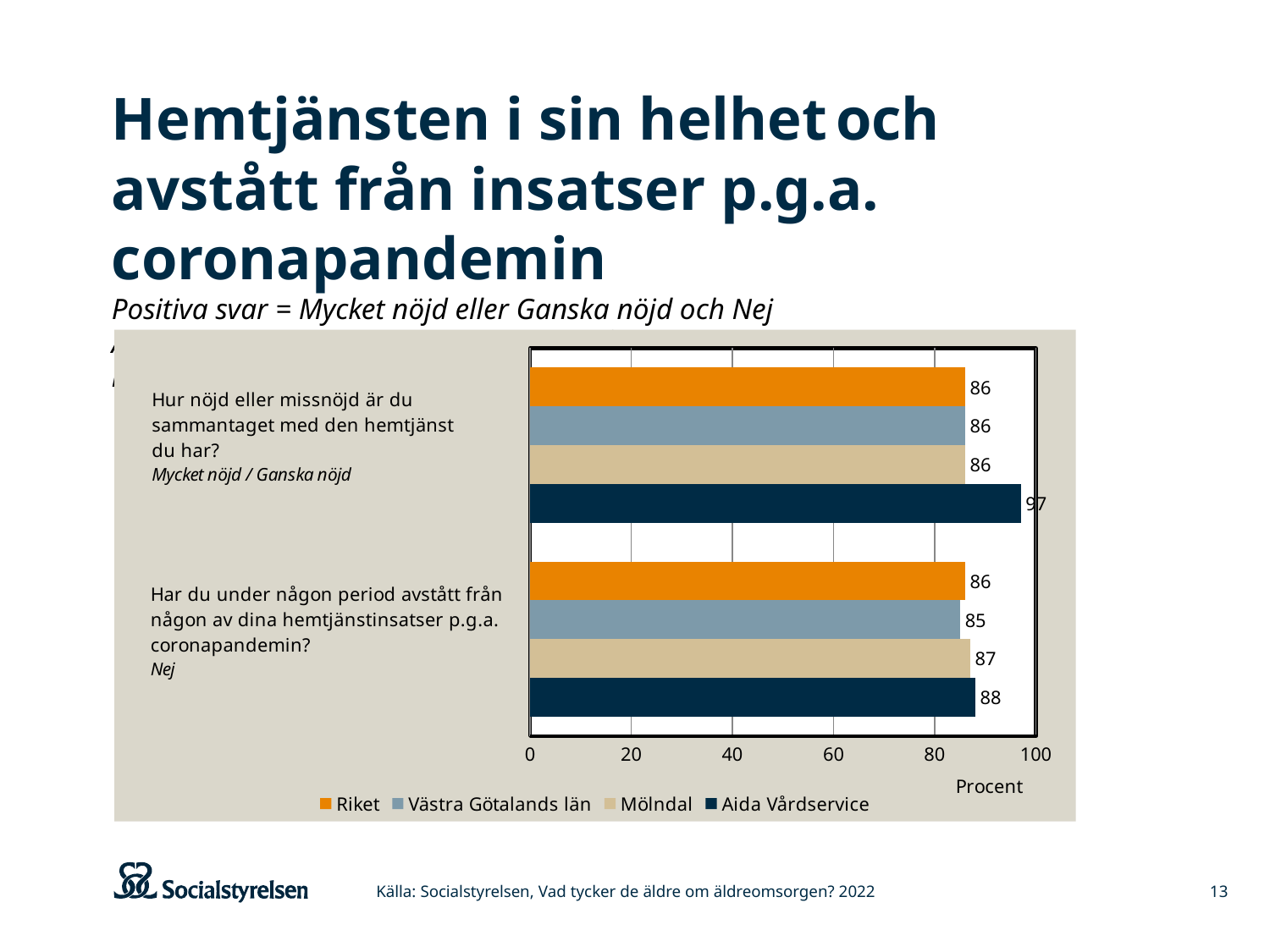
Which series has the lowest value for the question "Har du under någon period avstått från någon av dina hemtjänstinsatser p.g.a. coronapandemin?"? Västra Götalands län What value does Västra Götalands län have for the question "Har du under någon period avstått från någon av dina hemtjänstinsatser p.g.a. coronapandemin?"? 85 What is the difference between Aida Vårdservice and Riket for the question "Hur nöjd eller missnöjd är du sammantaget med den hemtjänst du har?"? 11 What value does Mölndal have for the question "Hur nöjd eller missnöjd är du sammantaget med den hemtjänst du har?"? 86 What kind of chart is shown on the slide? Bar chart What value does Aida Vårdservice have for the question "Hur nöjd eller missnöjd är du sammantaget med den hemtjänst du har?"? 97 How many series does the legend list? 4 What value does Riket have for the question "Har du under någon period avstått från någon av dina hemtjänstinsatser p.g.a. coronapandemin?"? 86 What is the difference between Aida Vårdservice and Mölndal for the question "Har du under någon period avstått från någon av dina hemtjänstinsatser p.g.a. coronapandemin?"? 1 Which is larger for Aida Vårdservice: the value for the question about overall satisfaction with home care ("Hur nöjd eller missnöjd...") or the value for the question about refraining from home care services due to the pandemic ("Har du under någon period avstått...")? Hur nöjd eller missnöjd är du sammantaget med den hemtjänst du har? What unit is shown on the horizontal axis of the chart? Procent Which series has the highest value for the question "Hur nöjd eller missnöjd är du sammantaget med den hemtjänst du har?"? Aida Vårdservice